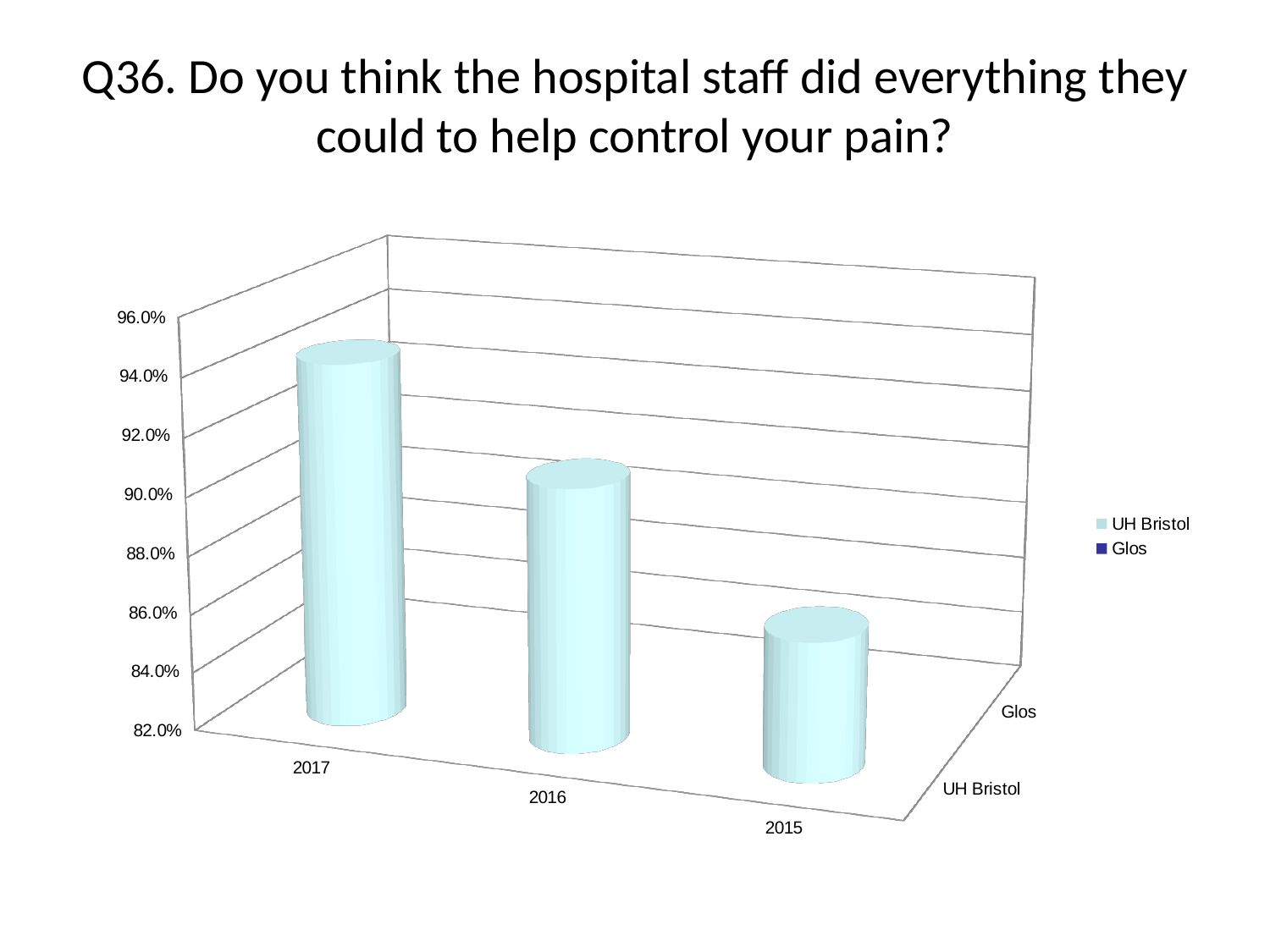
Is the UH Bristol value for 2016 larger or smaller than the value for 2017? smaller What kind of chart is shown on the slide? bar chart Is the UH Bristol value for 2017 greater or less than 90.0%? greater Is the UH Bristol value for 2016 greater or less than 88.0%? greater How many year categories are shown on the x axis of the chart? 3 Is the UH Bristol value for 2015 greater or less than 90.0%? less Which year has the highest UH Bristol value in the chart? 2017 Is the UH Bristol value for 2017 larger or smaller than the value for 2015? larger How many series does the chart legend list? 2 What are the two series names listed in the chart legend? UH Bristol and Glos Which year has the lowest UH Bristol value in the chart? 2015 Do the UH Bristol values rise or fall moving from 2017 to 2015 along the x axis? fall